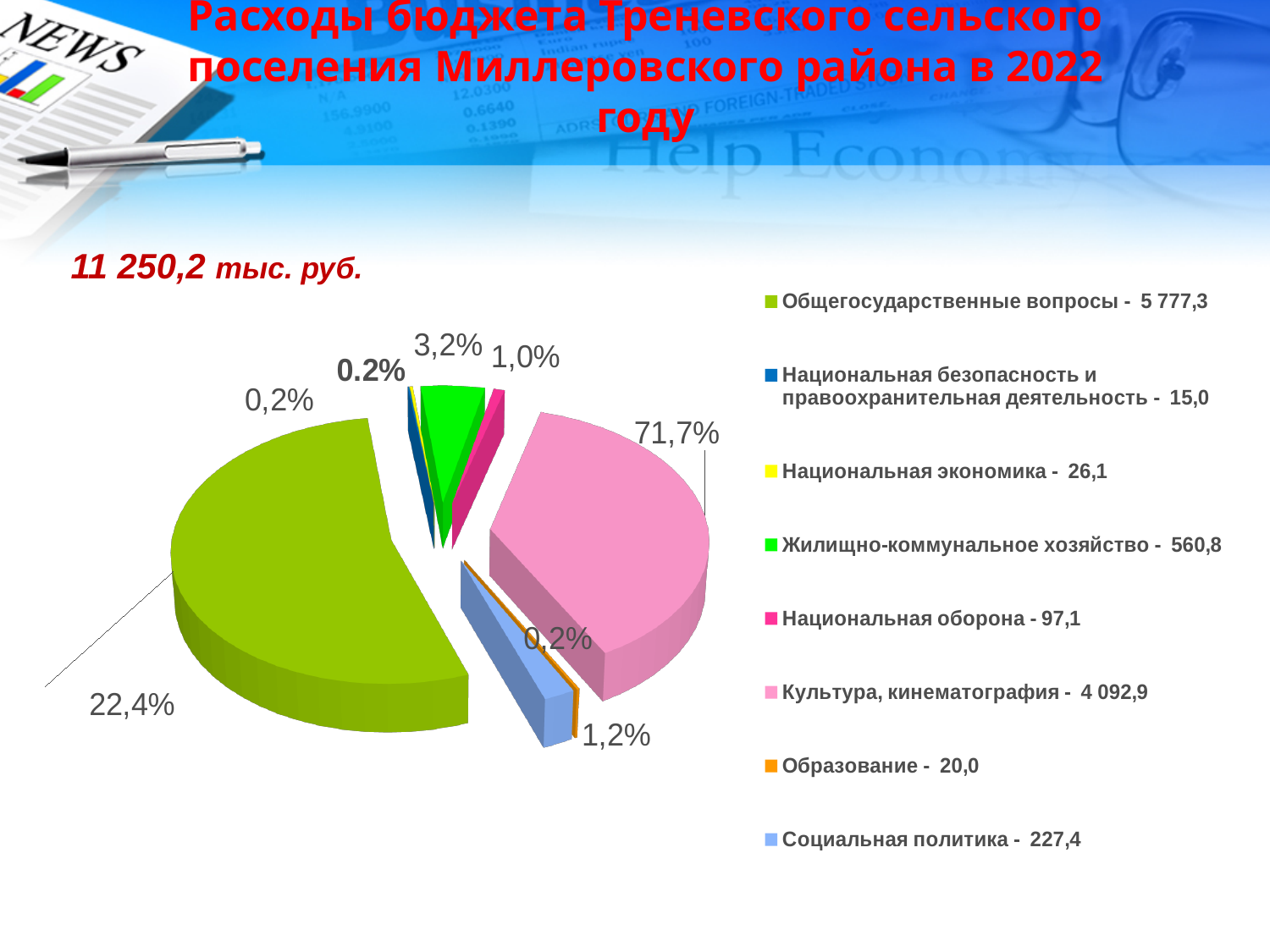
What total amount is printed above the pie chart? 11 250,2 тыс. руб. Which category has the largest value in the legend? Общегосударственные вопросы Which is larger according to the legend: Социальная политика or Жилищно-коммунальное хозяйство? Жилищно-коммунальное хозяйство Which is larger according to the legend: Образование or Национальная экономика? Национальная экономика What value is given in the legend for Социальная политика? 227,4 What value is given in the legend for Национальная оборона? 97,1 By how much does the legend value for Общегосударственные вопросы exceed that for Культура, кинематография? 1 684,4 What value is given in the legend for Жилищно-коммунальное хозяйство? 560,8 Which category has the smallest value in the legend? Национальная безопасность и правоохранительная деятельность What value is given in the legend for Культура, кинематография? 4 092,9 What kind of chart is shown on the slide? pie chart How many categories does the legend of the pie chart list? 8